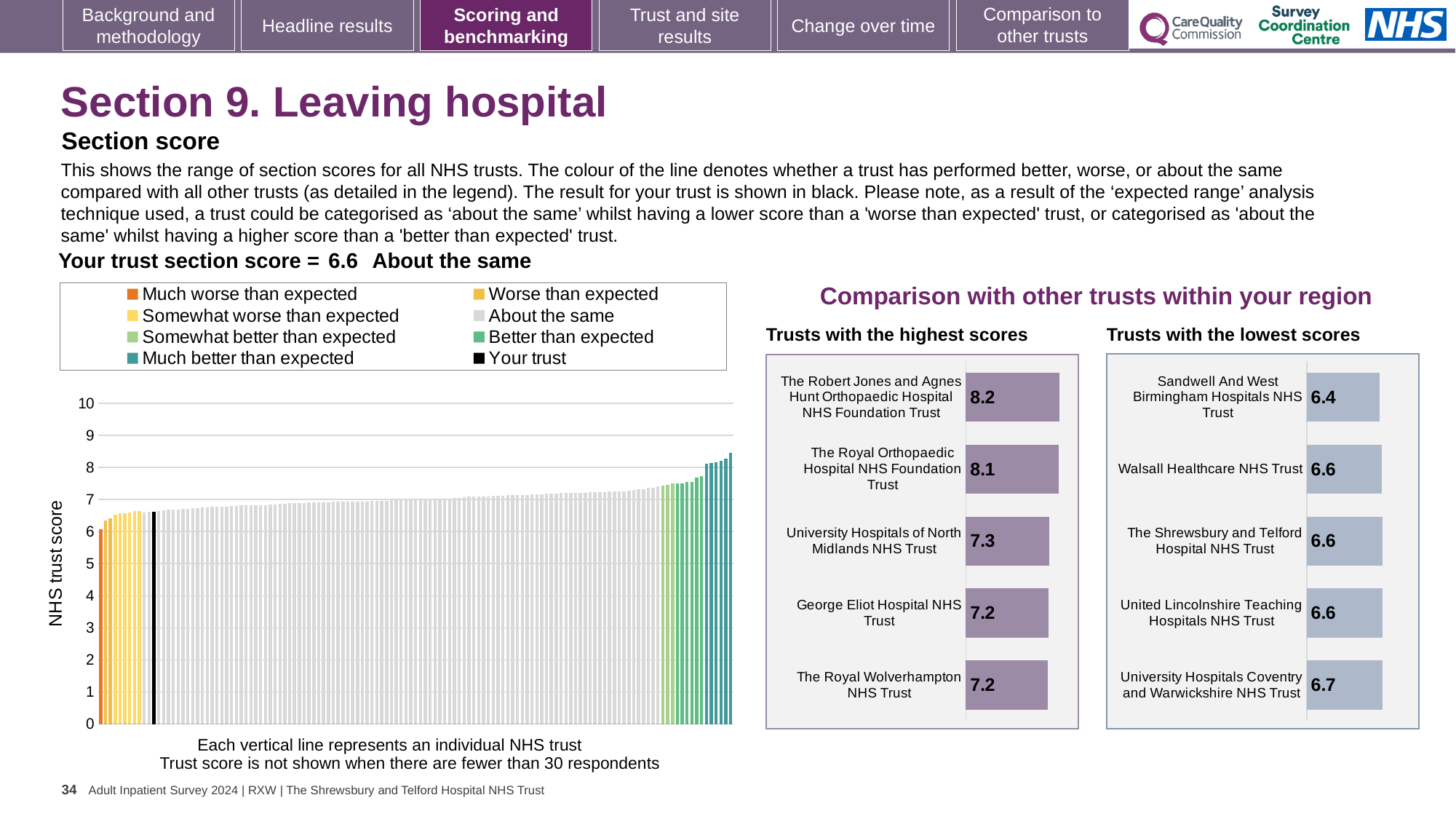
In the large 'NHS trust score' chart on the left, what is the section score for your trust (the black bar)? 6.6 In the 'Trusts with the lowest scores' chart, which trust has the lowest score? Sandwell And West Birmingham Hospitals NHS Trust In the 'Trusts with the lowest scores' chart, what is the score for Sandwell And West Birmingham Hospitals NHS Trust? 6.4 How many trusts are shown in the 'Trusts with the lowest scores' chart? 5 In the 'Trusts with the highest scores' chart, which trust has the highest score? The Robert Jones and Agnes Hunt Orthopaedic Hospital NHS Foundation Trust How many entries does the legend of the large 'NHS trust score' chart on the left list? 8 In the 'Trusts with the highest scores' chart, which has the higher score: The Royal Orthopaedic Hospital NHS Foundation Trust or George Eliot Hospital NHS Trust? The Royal Orthopaedic Hospital NHS Foundation Trust What kind of chart is the large 'NHS trust score' chart on the left of the slide? bar chart In the large 'NHS trust score' chart on the left, is the value of the tallest bar greater or less than 8? greater In the 'Trusts with the lowest scores' chart, what is the difference between the scores of University Hospitals Coventry and Warwickshire NHS Trust and Sandwell And West Birmingham Hospitals NHS Trust? 0.3 In the 'Trusts with the highest scores' chart, what is the score for The Robert Jones and Agnes Hunt Orthopaedic Hospital NHS Foundation Trust? 8.2 In the 'Trusts with the highest scores' chart, what is the difference between the scores of The Robert Jones and Agnes Hunt Orthopaedic Hospital NHS Foundation Trust and University Hospitals of North Midlands NHS Trust? 0.9